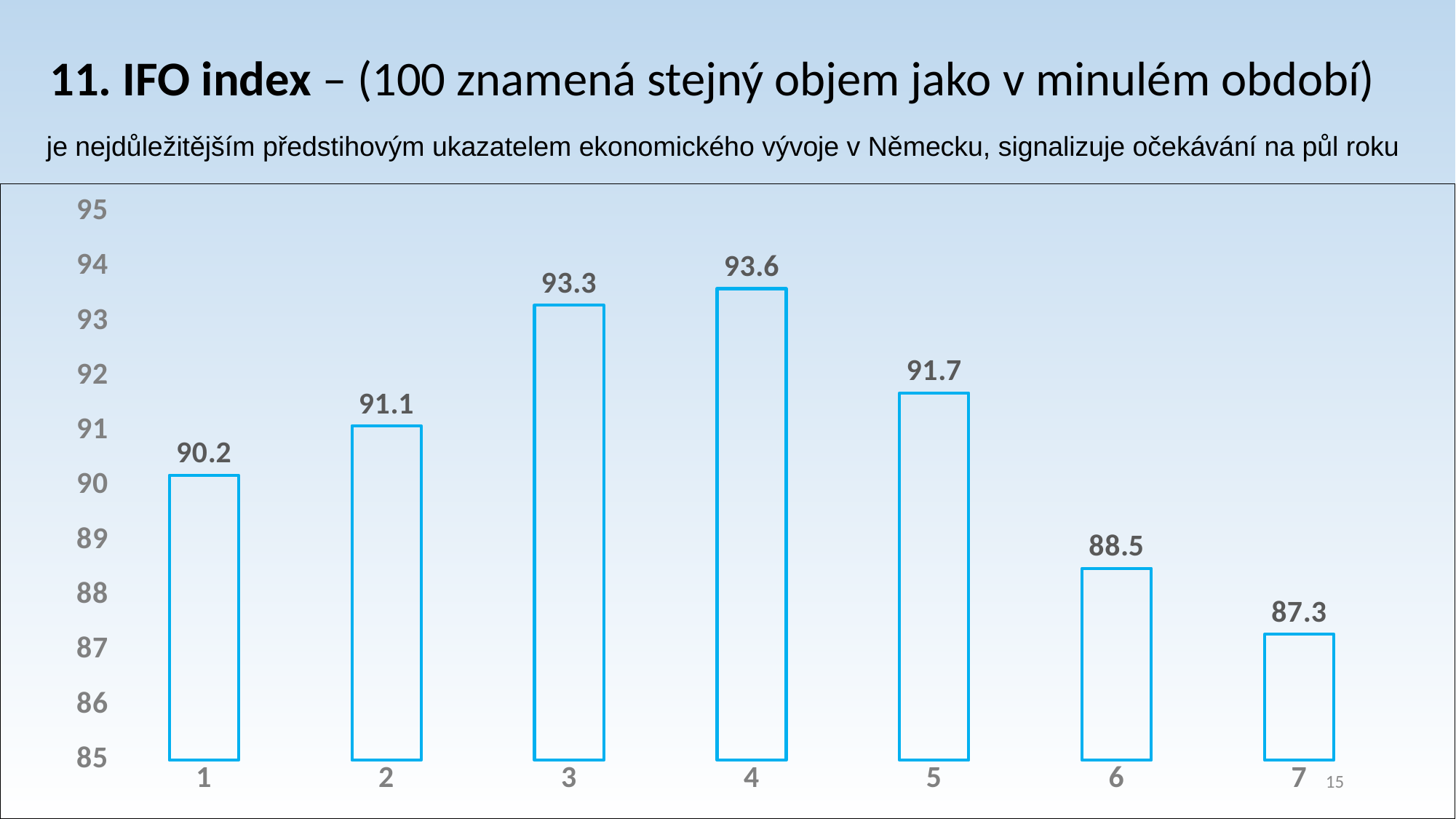
Which category has the lowest IFO index value? 7 Which is larger, the value for category 3 or the value for category 5? category 3 How many categories are shown on the x axis? 7 Do the values rise or fall from category 4 to category 7? fall Is the value for category 6 greater or less than 90? less What is the difference between the values for category 4 and category 7? 6.3 What kind of chart is shown on the slide? bar chart What is the IFO index value for category 1? 90.2 What is the IFO index value for category 4? 93.6 What is the difference between the values for category 2 and category 1? 0.9 Which category has the highest IFO index value? 4 What is the IFO index value for category 7? 87.3